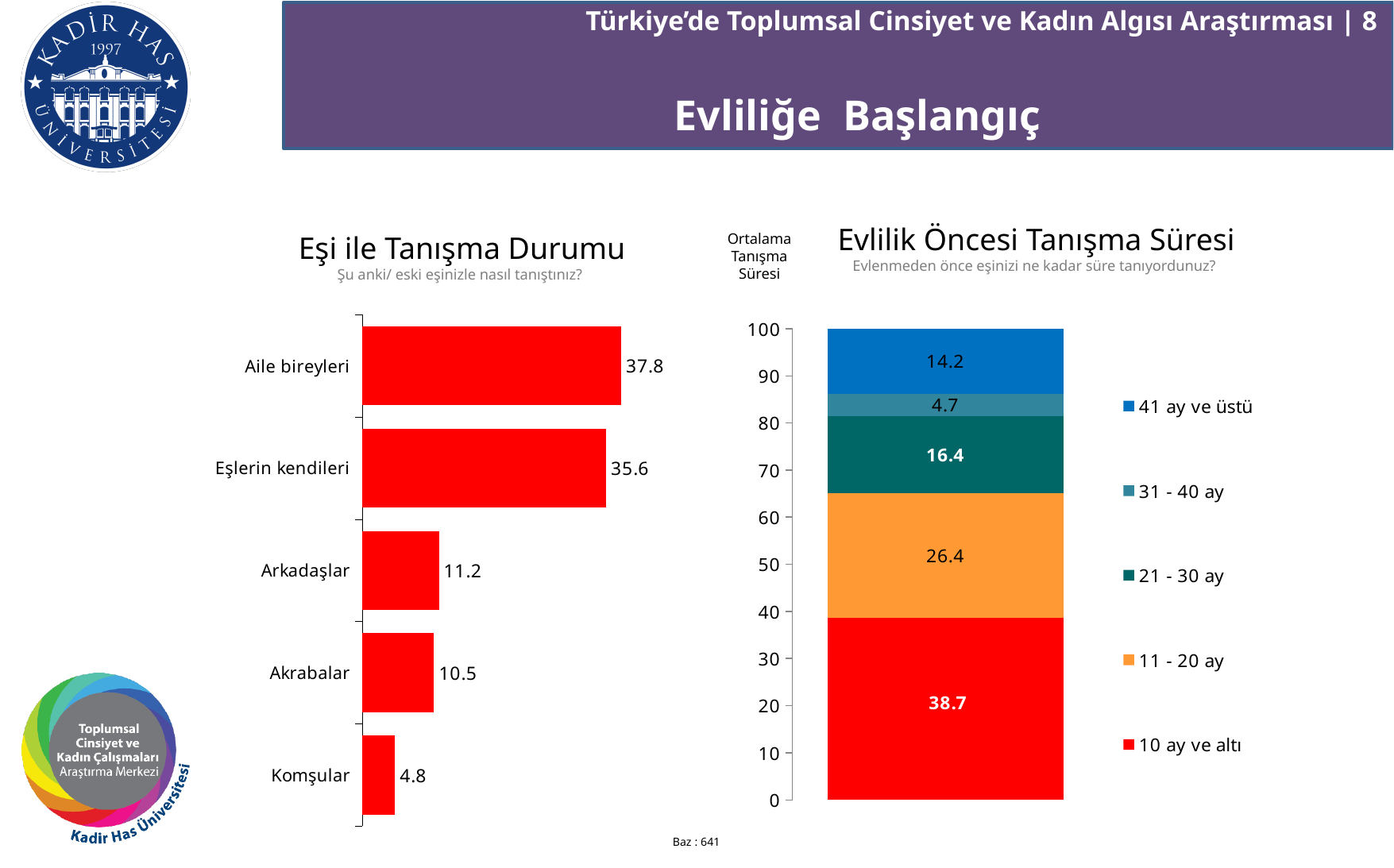
In the 'Eşi ile Tanışma Durumu' chart, which category has the highest value? Aile bireyleri In the 'Evlilik Öncesi Tanışma Süresi' chart, how many series does the legend list? 5 In the 'Eşi ile Tanışma Durumu' chart, how many categories are shown? 5 In the 'Evlilik Öncesi Tanışma Süresi' chart, which is larger: '21 - 30 ay' or '41 ay ve üstü'? 21 - 30 ay In the 'Evlilik Öncesi Tanışma Süresi' chart, what is the value for '10 ay ve altı'? 38.7 In the 'Eşi ile Tanışma Durumu' chart, what is the value for Aile bireyleri? 37.8 In the 'Evlilik Öncesi Tanışma Süresi' chart, what is the difference between '11 - 20 ay' and '21 - 30 ay'? 10.0 In the 'Eşi ile Tanışma Durumu' chart, which category has the lowest value? Komşular In the 'Evlilik Öncesi Tanışma Süresi' chart, what is the value for '31 - 40 ay'? 4.7 In the 'Eşi ile Tanışma Durumu' chart, what is the difference between Aile bireyleri and Eşlerin kendileri? 2.2 What kind of chart is 'Eşi ile Tanışma Durumu'? Bar chart In the 'Eşi ile Tanışma Durumu' chart, what is the value for Komşular? 4.8